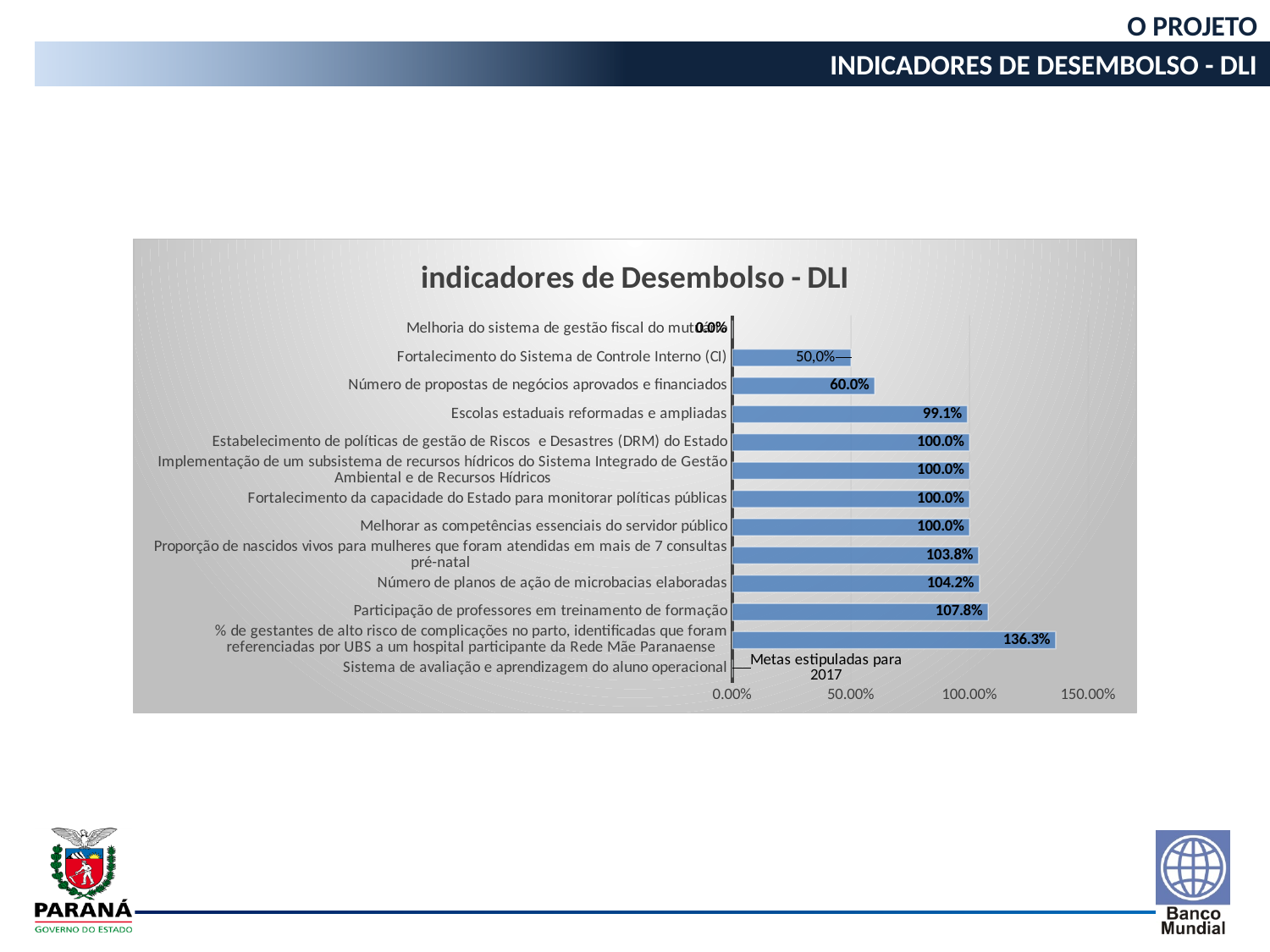
Which is larger: the value for 'Número de planos de ação de microbacias elaboradas' or 'Proporção de nascidos vivos para mulheres que foram atendidas em mais de 7 consultas pré-natal'? Número de planos de ação de microbacias elaboradas What is the difference between the value for '% de gestantes de alto risco...' (136.3%) and 'Participação de professores em treinamento de formação' (107.8%)? 28.5 percentage points What is the value for 'Número de propostas de negócios aprovados e financiados'? 60.0% What type of chart is shown on the slide? bar chart What is the value for 'Fortalecimento do Sistema de Controle Interno (CI)'? 50,0% What is the value for 'Melhorar as competências essenciais do servidor público'? 100.0% What is the title of the chart? indicadores de Desembolso - DLI Which indicator has the highest value? % de gestantes de alto risco de complicações no parto, identificadas que foram referenciadas por UBS a um hospital participante da Rede Mãe Paranaense What is the value for 'Escolas estaduais reformadas e ampliadas'? 99.1% What is the value for 'Participação de professores em treinamento de formação'? 107.8% What is the value for 'Número de planos de ação de microbacias elaboradas'? 104.2% Is the value for 'Número de propostas de negócios aprovados e financiados' greater or less than 100.00%? less